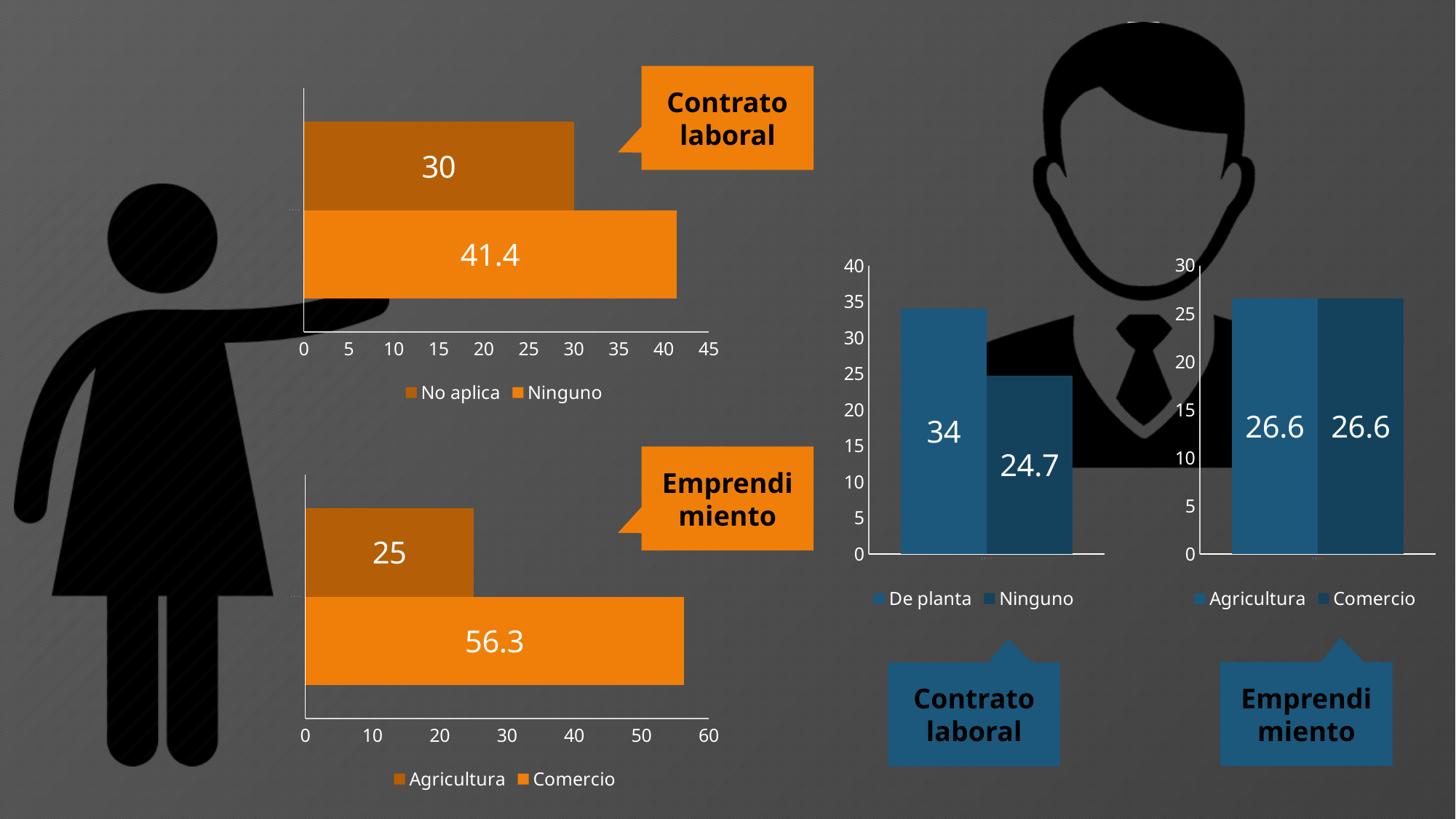
In the orange horizontal bar chart labelled 'Emprendimiento' at the bottom left, what is the value for Comercio? 56.3 In the orange horizontal bar chart labelled 'Contrato laboral' at the top left, what is the value for Ninguno? 41.4 How many series does the legend list in the blue vertical bar chart labelled 'Emprendimiento' at the far right? 2 In the blue vertical bar chart labelled 'Contrato laboral' on the right, which is larger, De planta or Ninguno? De planta In the blue vertical bar chart labelled 'Emprendimiento' at the far right, what is the value for Comercio? 26.6 In the orange horizontal bar chart labelled 'Emprendimiento' at the bottom left, what is the difference between Comercio and Agricultura? 31.3 In the orange horizontal bar chart labelled 'Contrato laboral' at the top left, what is the value for No aplica? 30 In the blue vertical bar chart labelled 'Contrato laboral' on the right, what is the difference between De planta and Ninguno? 9.3 In the orange horizontal bar chart labelled 'Contrato laboral' at the top left, what is the difference between Ninguno and No aplica? 11.4 In the blue vertical bar chart labelled 'Contrato laboral' on the right, what is the value for De planta? 34 What kind of chart is the orange chart labelled 'Contrato laboral' at the top left? Bar chart In the orange horizontal bar chart labelled 'Emprendimiento' at the bottom left, which series has the lowest value? Agricultura